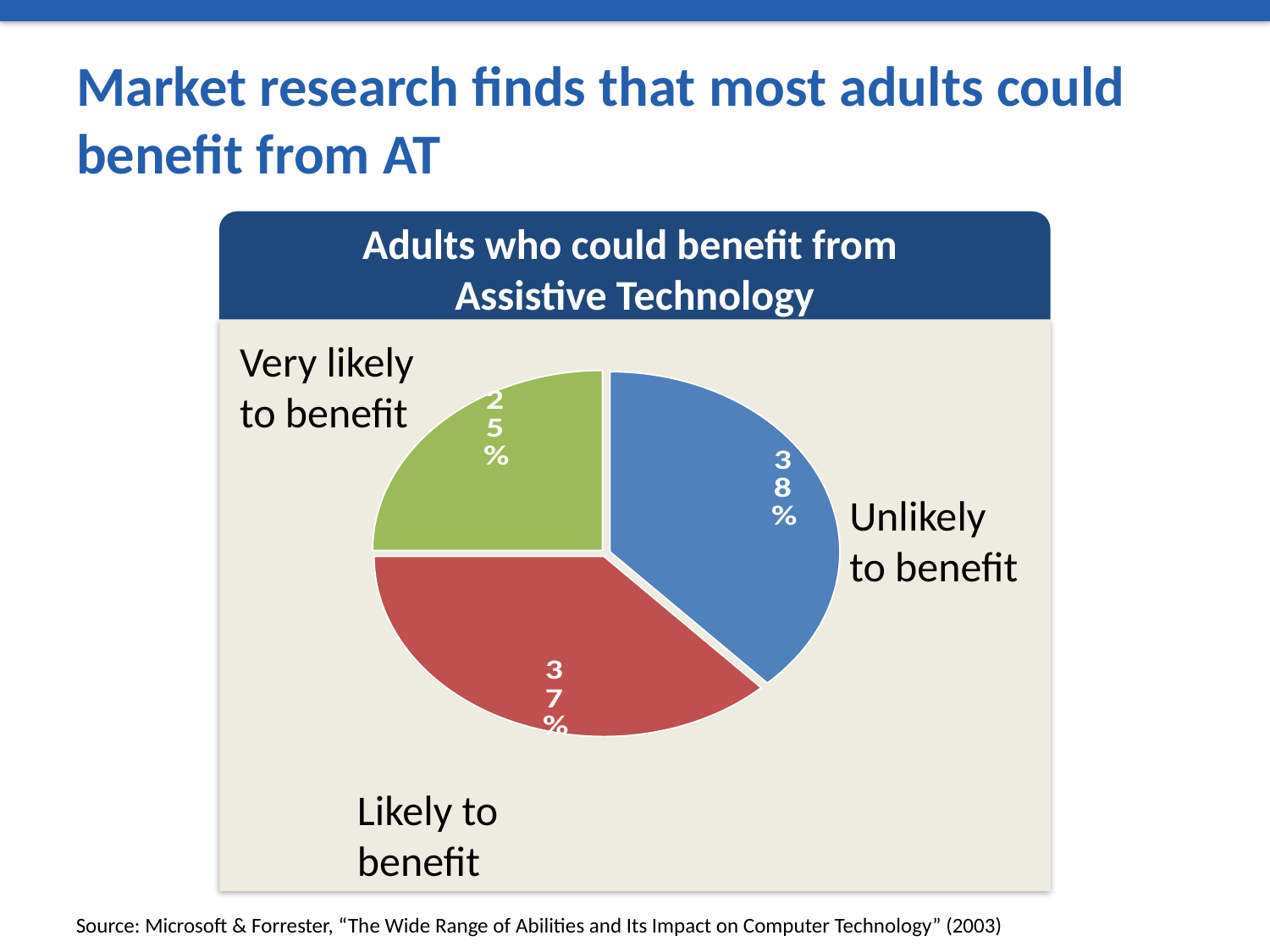
What is the title of the chart? Adults who could benefit from Assistive Technology What is the difference in percentage points between the 'Likely to benefit' and 'Very likely to benefit' slices? 12 Which category has the largest slice of the pie? Unlikely to benefit What percentage of adults are very likely to benefit from assistive technology? 25% What percentage of adults are unlikely to benefit from assistive technology? 38% What percentage of adults are likely to benefit from assistive technology? 37% How many slices does the pie chart have? 3 What kind of chart is shown on the slide? pie chart What is the difference in percentage points between the 'Unlikely to benefit' and 'Very likely to benefit' slices? 13 Which category has the smallest slice of the pie? Very likely to benefit Which is larger, the 'Likely to benefit' slice or the 'Very likely to benefit' slice? Likely to benefit What colour is the 'Very likely to benefit' slice? green